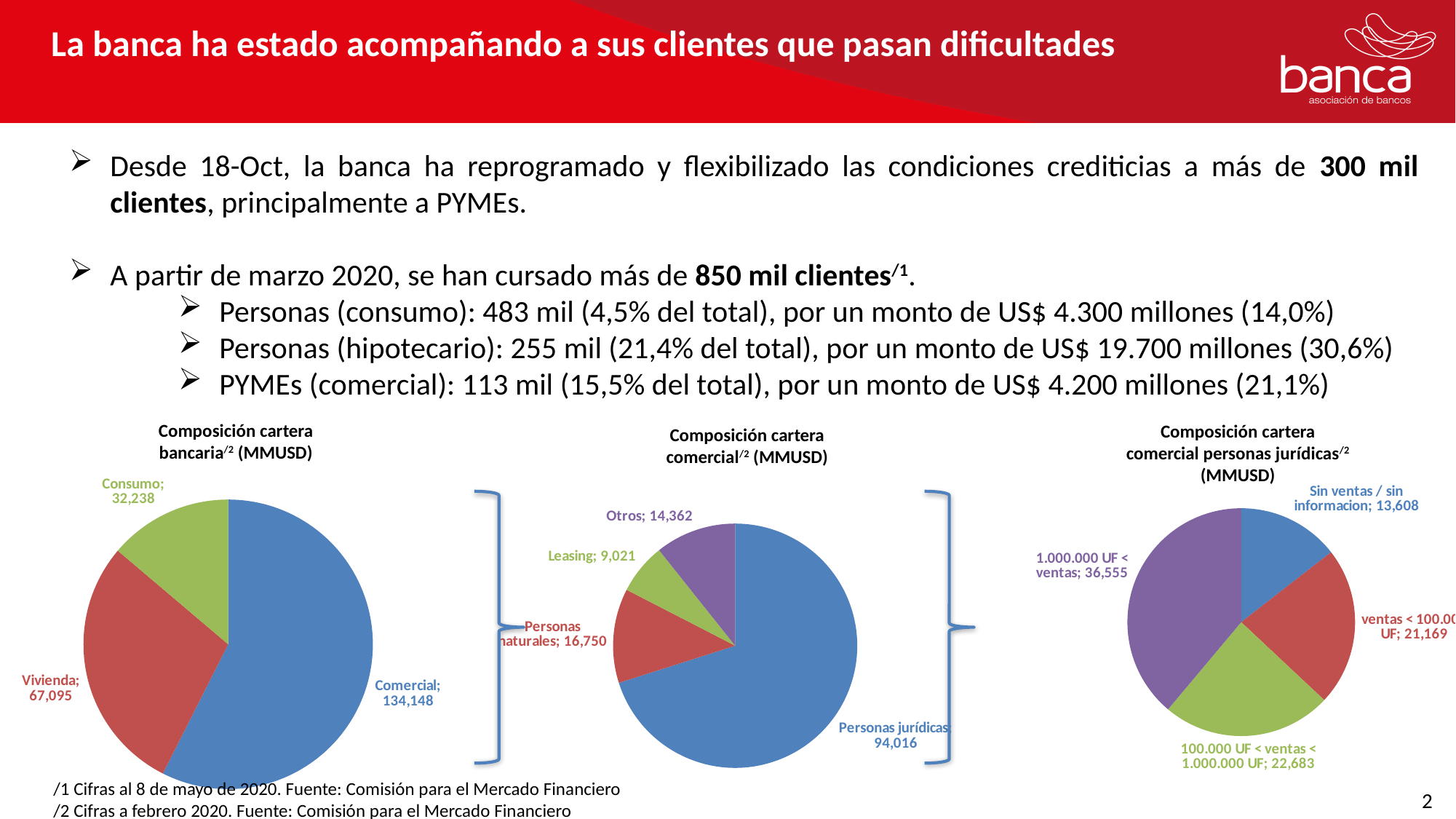
In the 'Composición cartera comercial personas jurídicas (MMUSD)' chart, what is the value for '1.000.000 UF < ventas'? 36,555 How many slices does the 'Composición cartera bancaria (MMUSD)' chart have? 3 What type of chart is used for the 'Composición cartera bancaria (MMUSD)' chart? Pie chart In the 'Composición cartera comercial personas jurídicas (MMUSD)' chart, what is the difference between '1.000.000 UF < ventas' and 'Sin ventas / sin informacion'? 22,947 In the 'Composición cartera bancaria (MMUSD)' chart, what is the difference between Comercial and Vivienda? 67,053 In the 'Composición cartera comercial (MMUSD)' chart, which is larger: Otros or Personas naturales? Personas naturales In the 'Composición cartera bancaria (MMUSD)' chart, which category has the smallest value? Consumo In the 'Composición cartera bancaria (MMUSD)' chart, what is the value for Comercial? 134,148 In the 'Composición cartera comercial personas jurídicas (MMUSD)' chart, which category has the smallest value? Sin ventas / sin informacion In the 'Composición cartera comercial (MMUSD)' chart, what is the value for Leasing? 9,021 How many categories are shown in the 'Composición cartera comercial (MMUSD)' chart? 4 In the 'Composición cartera comercial (MMUSD)' chart, which category has the largest value? Personas jurídicas